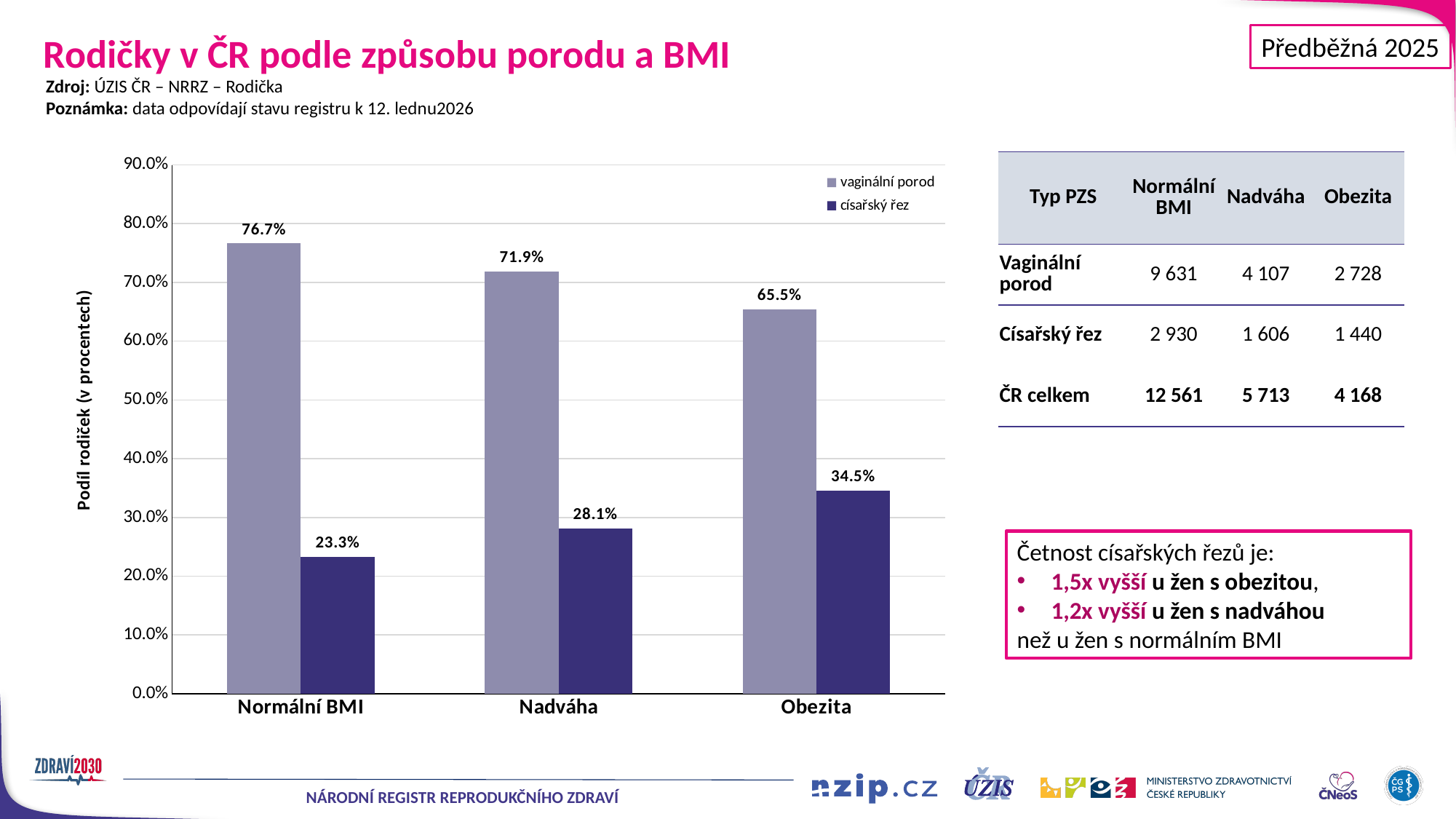
How many series does the chart legend list? 2 Which is larger: the císařský řez value for Normální BMI or for Obezita? Obezita Which category has the highest value for císařský řez? Obezita Which category has the lowest value for vaginální porod? Obezita What is the value for vaginální porod in the Normální BMI category? 76.7% What is the value for císařský řez in the Obezita category? 34.5% Is the value for vaginální porod in the Obezita category greater or less than 70.0%? less Do the vaginální porod values rise or fall from Normální BMI to Obezita? fall What kind of chart is shown on the slide? bar chart What is the difference between the vaginální porod and císařský řez values in the Nadváha category? 43.8% How many categories are shown on the x axis of the chart? 3 What is the value for císařský řez in the Nadváha category? 28.1%